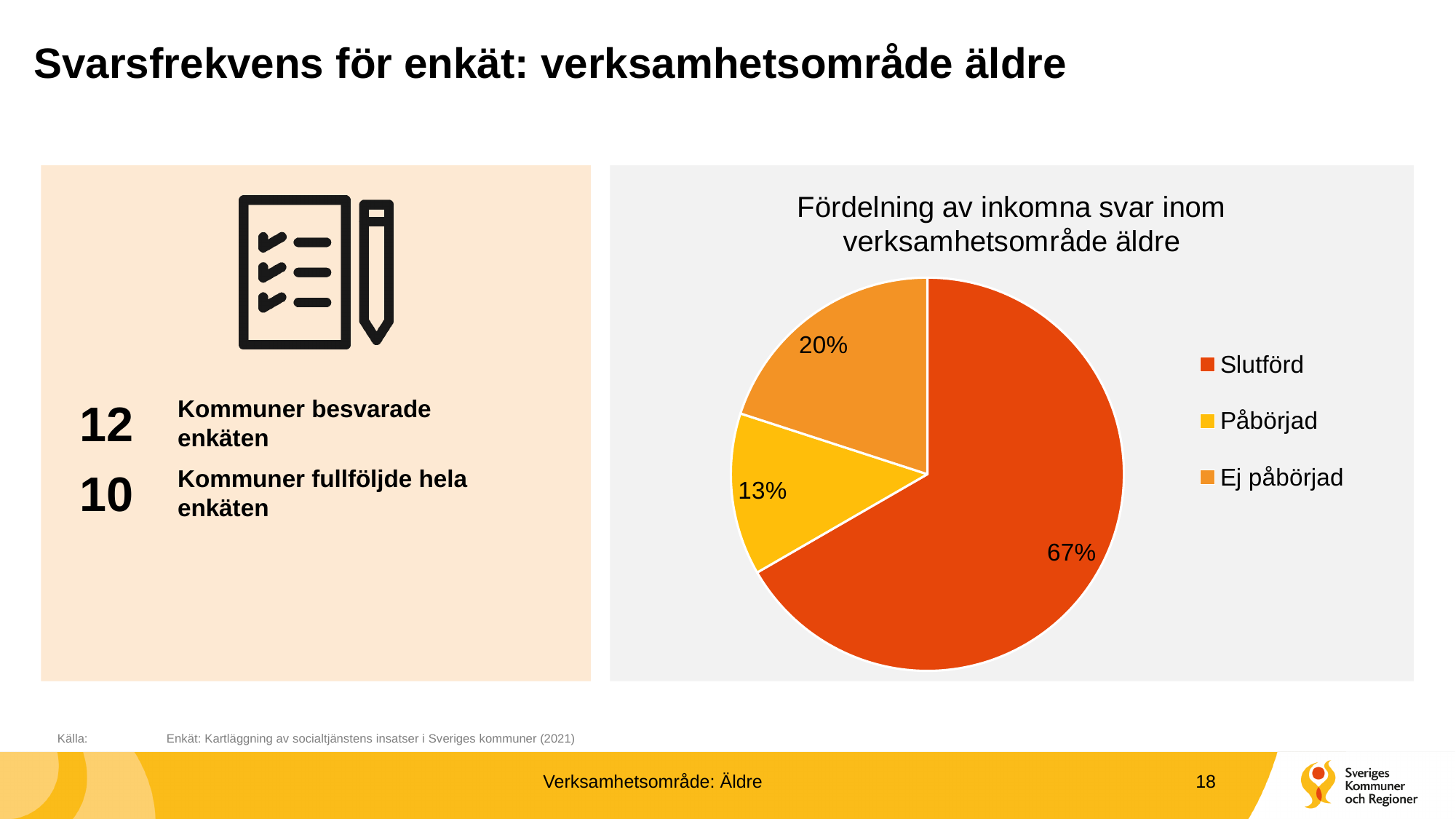
Which category has the largest slice of the pie? Slutförd What kind of chart is shown on the slide? pie chart How many entries does the legend list? 3 How many categories does the pie chart show? 3 What is the title of the pie chart? Fördelning av inkomna svar inom verksamhetsområde äldre What colour is the Slutförd slice in the pie chart? red-orange What is the difference in percentage points between Slutförd and Ej påbörjad? 47 What share of the pie does Ej påbörjad have? 20% Which is larger, the share for Ej påbörjad or the share for Påbörjad? Ej påbörjad What share of the pie does Påbörjad have? 13% What share of the pie does Slutförd have? 67% Which category has the smallest slice of the pie? Påbörjad